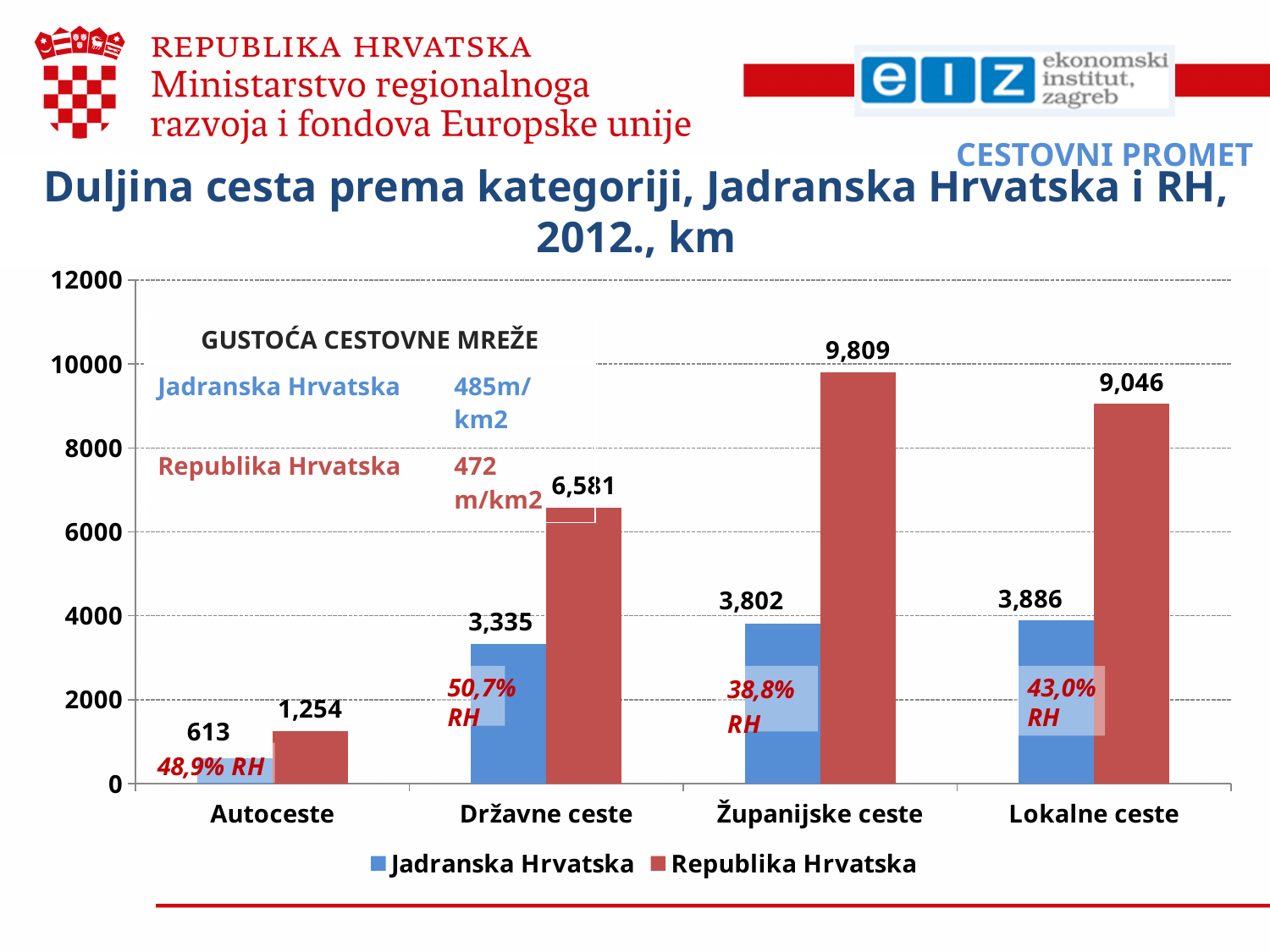
Which is larger for Jadranska Hrvatska: Državne ceste or Županijske ceste? Županijske ceste What kind of chart is shown on the slide? Bar chart What is the value for Republika Hrvatska in the Županijske ceste category? 9,809 How many series does the legend list? 2 Which category has the lowest value for Jadranska Hrvatska? Autoceste What is the value for Jadranska Hrvatska in the Lokalne ceste category? 3,886 What is the value for Jadranska Hrvatska in the Autoceste category? 613 What is the value for Republika Hrvatska in the Državne ceste category? 6,581 Which colour represents Republika Hrvatska in the chart? Red What is the difference between the Republika Hrvatska and Jadranska Hrvatska values for Lokalne ceste? 5,160 Which category has the highest value for Republika Hrvatska? Županijske ceste How many categories are shown on the x axis? 4